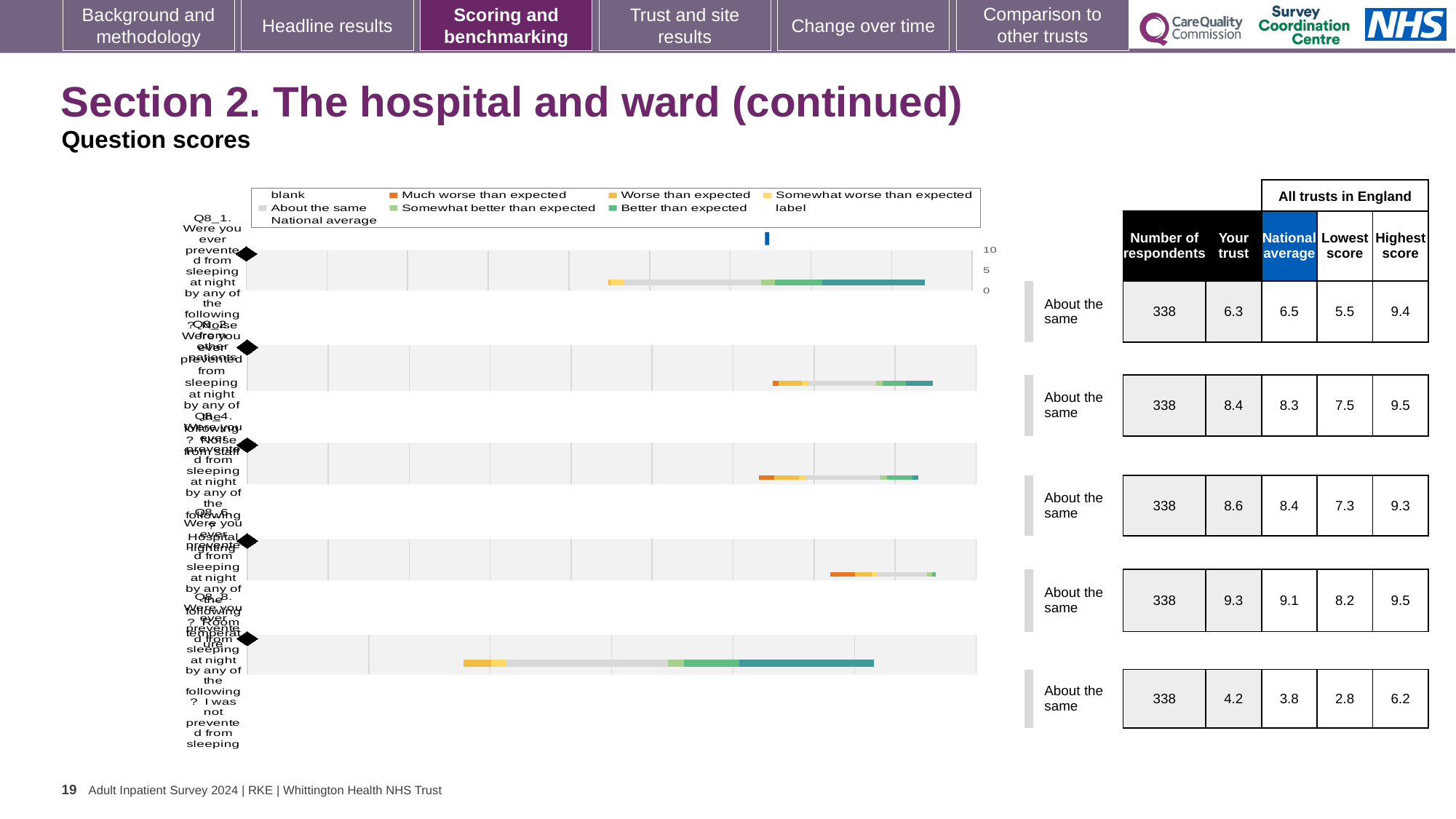
Which question has the lowest 'Your trust' score? Q8_8 Which question has the highest 'Your trust' score? Q8_6 How many question rows are plotted in the chart? 5 What colour does the legend use for 'Much worse than expected'? Orange Is the 'Your trust' score for Q8_8 greater or less than 5? less What benchmark category is shown for every question in the chart? About the same For Q8_2, which is larger: the 'Your trust' score or the national average? Your trust What kind of chart is shown on the slide? Bar chart How many respondents are listed for Q8_4? 338 What is the 'Your trust' score for Q8_1 in the table beside the chart? 6.3 What is the national average for Q8_8 in the table beside the chart? 3.8 What is the difference between the national average and the 'Your trust' score for Q8_1? 0.2